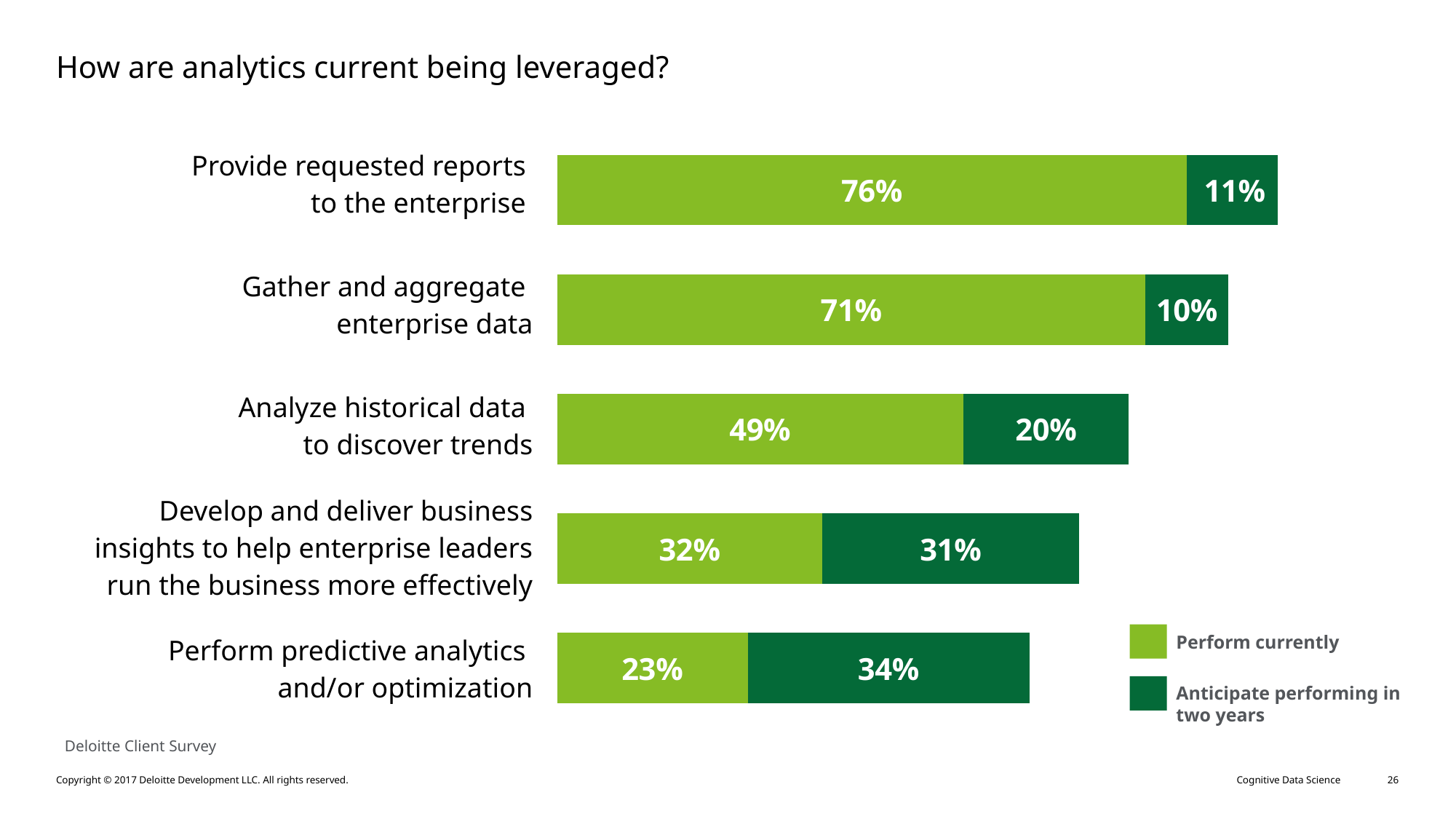
Which activity has the highest 'Perform currently' value? Provide requested reports to the enterprise What percentage anticipate performing 'Perform predictive analytics and/or optimization' in two years? 34% What percentage of respondents currently perform 'Provide requested reports to the enterprise'? 76% What is the difference between the 'Perform currently' values for 'Gather and aggregate enterprise data' and 'Analyze historical data to discover trends'? 22% Is the 'Perform currently' value larger for 'Develop and deliver business insights to help enterprise leaders run the business more effectively' or for 'Perform predictive analytics and/or optimization'? Develop and deliver business insights to help enterprise leaders run the business more effectively Which activity has the highest 'Anticipate performing in two years' value? Perform predictive analytics and/or optimization What type of chart is shown on the slide? Stacked bar chart How many activities are shown in the chart? 5 What is the 'Perform currently' value for 'Analyze historical data to discover trends'? 49% Which activity has the lowest 'Perform currently' value? Perform predictive analytics and/or optimization How many series does the legend list? 2 What is the combined total of the two segments for 'Provide requested reports to the enterprise'? 87%